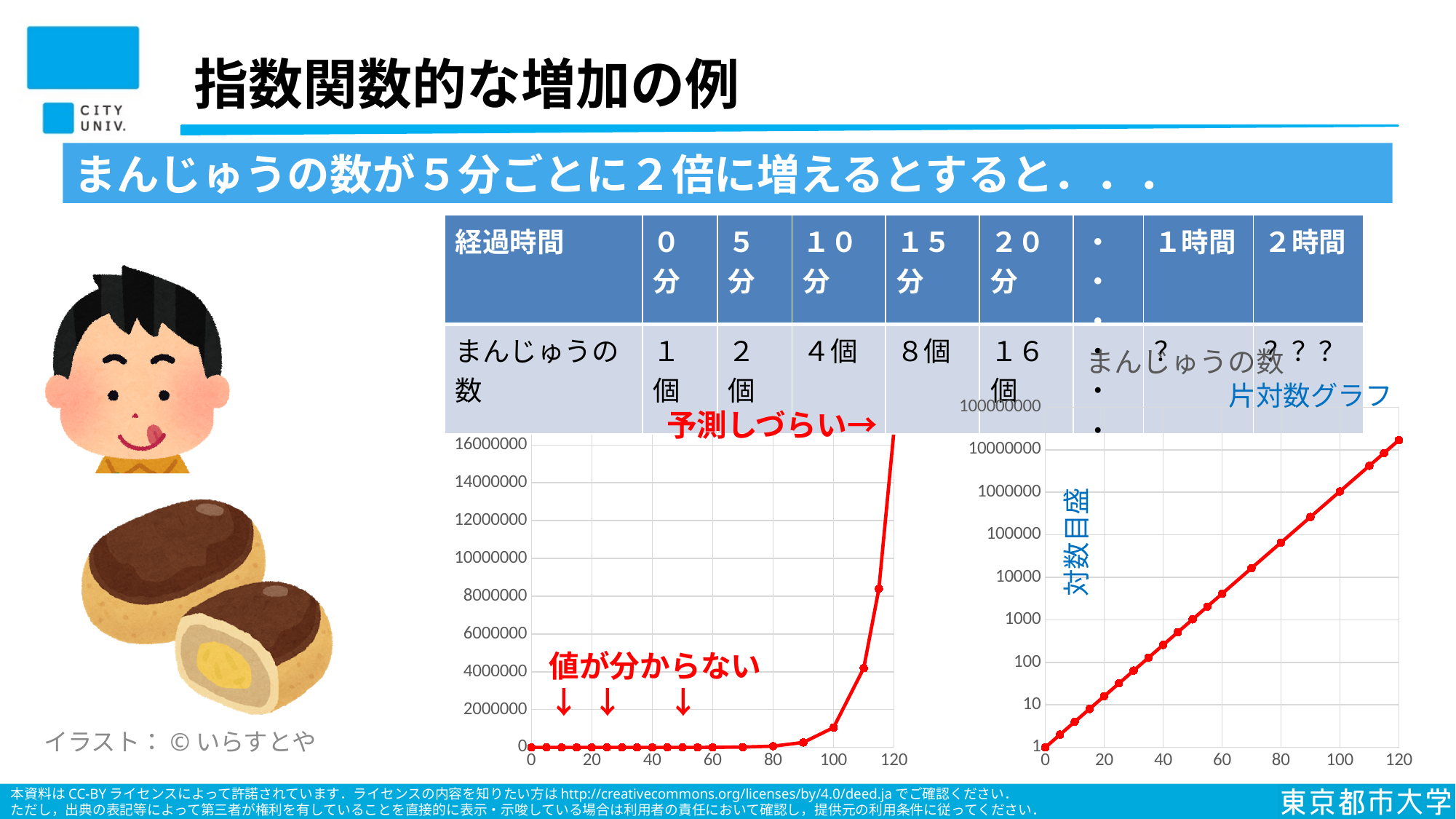
What kind of chart is the left chart on the slide? line chart In the right chart (片対数グラフ), what is the value at x = 0? 1 In the left chart, is the value at x = 100 greater or less than 2000000? less What kind of chart is the right chart (片対数グラフ) on the slide? line chart What is the largest tick value shown on the x axis of the left chart? 120 In the left chart, do the values rise or fall as the x axis increases from 0 to 120? rise What is the y-axis label written on the right chart? 対数目盛 In the left chart, is the value at x = 110 greater or less than 2000000? greater In the right chart (片対数グラフ), is the value at x = 60 greater or less than 1000? greater In the left chart, which x value has the highest plotted value? 120 In the right chart (片対数グラフ), do the values rise or fall along the x axis? rise